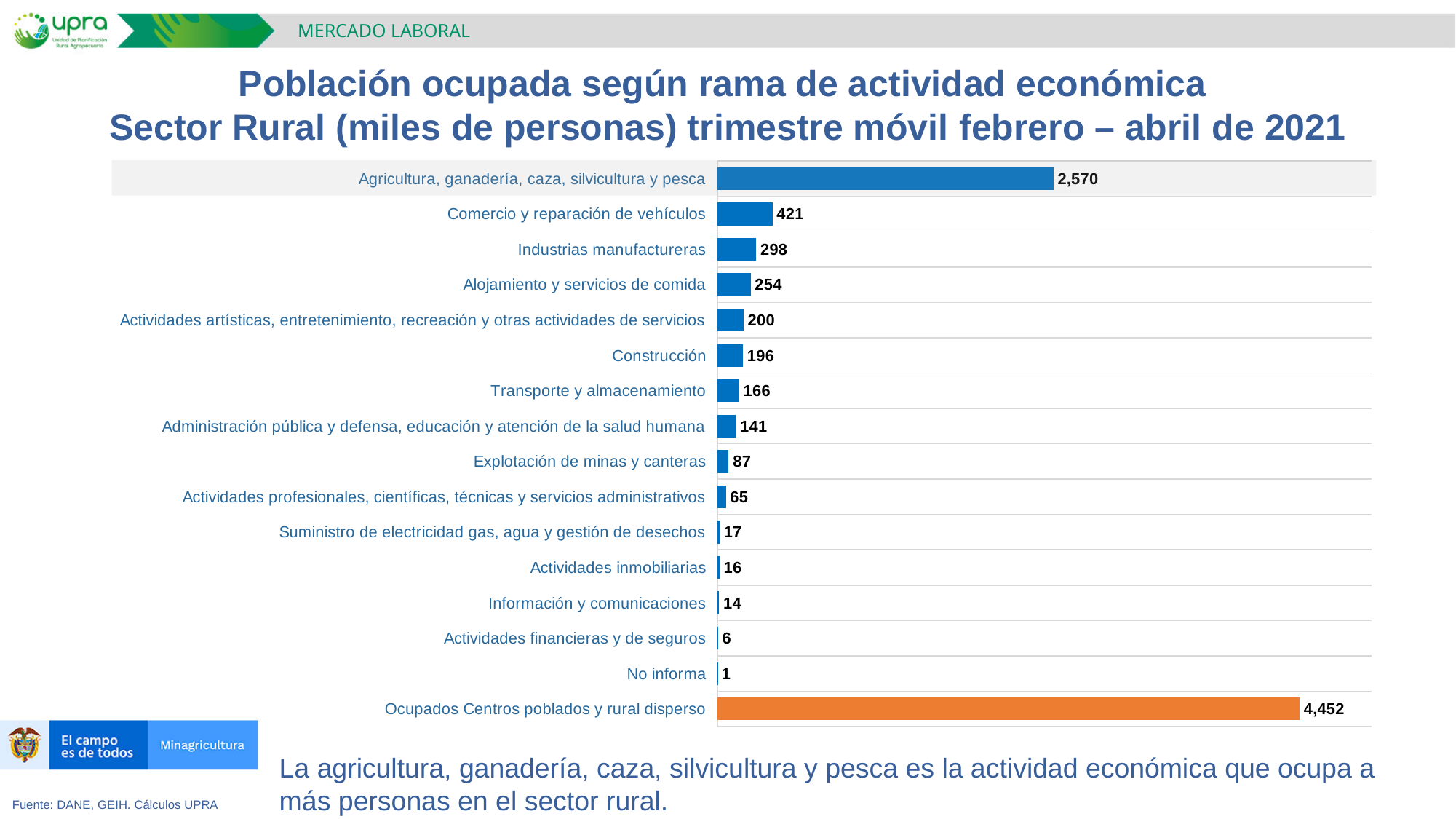
What is the difference between the values for Comercio y reparación de vehículos and Industrias manufactureras? 123 What is the value for Comercio y reparación de vehículos? 421 Which bar in the chart is coloured orange rather than blue? Ocupados Centros poblados y rural disperso Which category has the lowest value in the chart? No informa What is the value for Ocupados Centros poblados y rural disperso? 4,452 What is the value for Explotación de minas y canteras? 87 Which category has the longest bar in the chart? Ocupados Centros poblados y rural disperso How many bars are shown in the chart? 16 What is the difference between the values for Agricultura, ganadería, caza, silvicultura y pesca and Comercio y reparación de vehículos? 2,149 What type of chart is shown on the slide? Bar chart Which has a larger value, Construcción or Transporte y almacenamiento? Construcción What is the value for Agricultura, ganadería, caza, silvicultura y pesca? 2,570